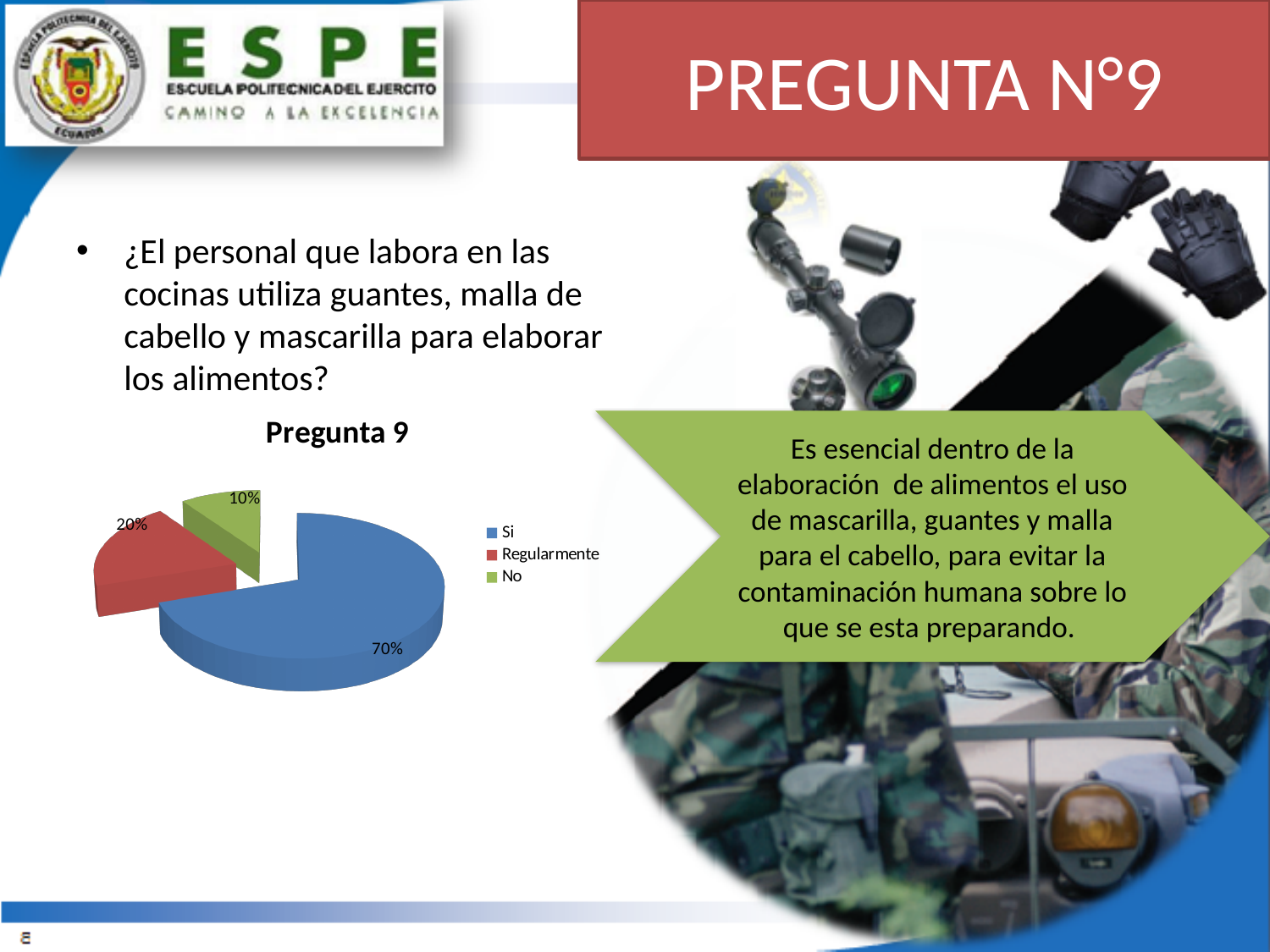
Which is larger, the share for "Regularmente" or the share for "No"? Regularmente How many categories does the legend list? 3 What colour is the slice for "Si"? blue Which category has the largest share of the pie? Si What percentage of the pie corresponds to "Si"? 70% Which category has the smallest share of the pie? No What kind of chart is shown on the slide? pie chart What percentage of the pie corresponds to "No"? 10% What is the difference between the shares for "Si" and "Regularmente"? 50% What is the title of the chart? Pregunta 9 What percentage of the pie corresponds to "Regularmente"? 20% What is the combined share of "Regularmente" and "No"? 30%